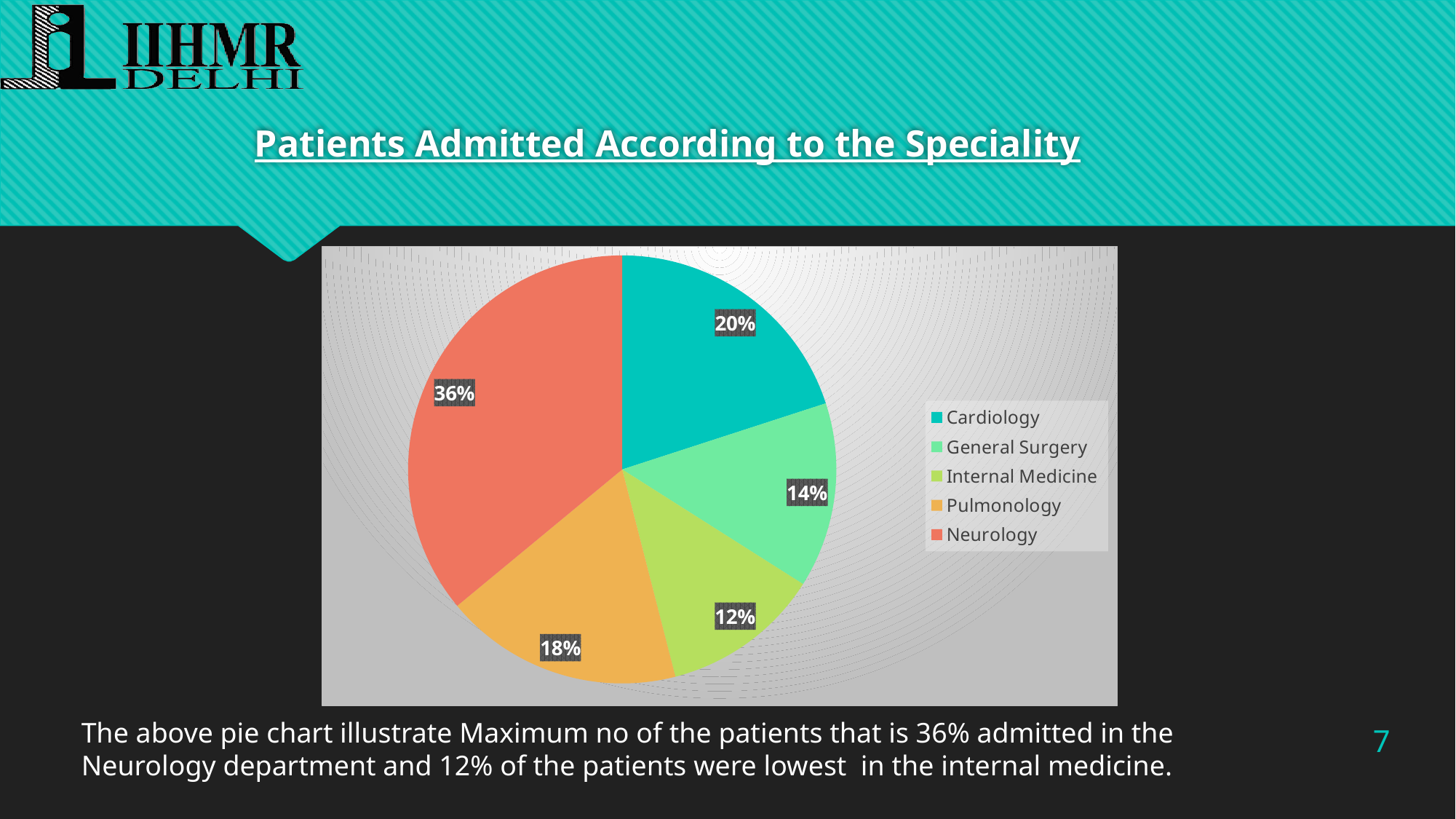
Which speciality has the largest share of admitted patients? Neurology What percentage of patients were admitted to Pulmonology? 18% What is the difference in percentage points between Neurology and Cardiology? 16 Which has a larger share, Pulmonology or General Surgery? Pulmonology What type of chart is shown on the slide? pie chart What percentage of patients were admitted to General Surgery? 14% What percentage of patients were admitted to Cardiology? 20% Which speciality has the smallest share of admitted patients? Internal Medicine What is the title of the chart? Patients Admitted According to the Speciality How many specialities are shown in the pie chart? 5 What percentage of patients were admitted to Neurology? 36%